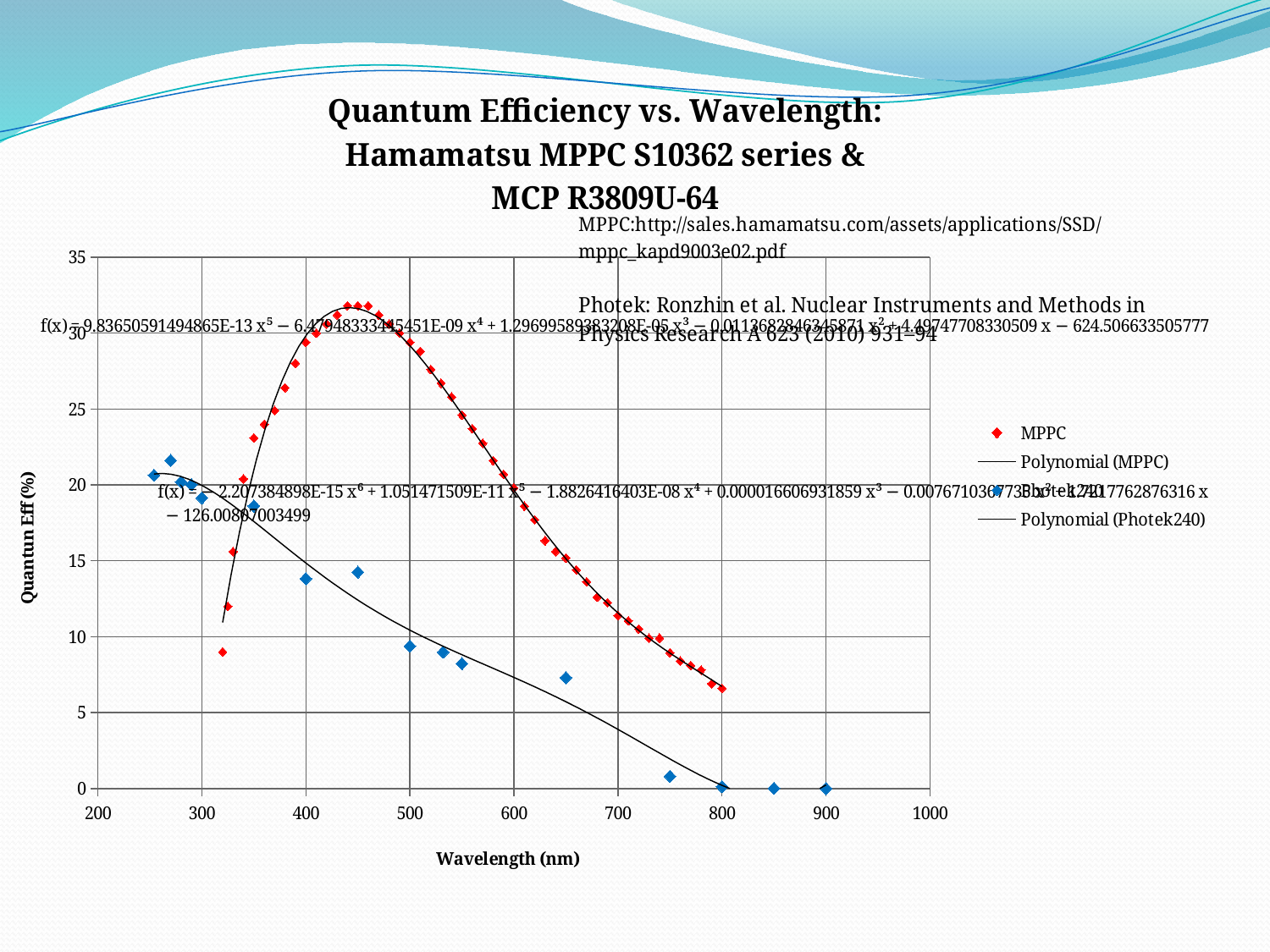
Do the MPPC values rise or fall as wavelength increases from 450 nm to 800 nm? fall Is the MPPC value at 800 nm greater or less than 10? less How many entries does the chart legend list? 4 What is the title of the vertical axis? Quantun Eff (%) What colour are the MPPC data markers? red Is the Photek240 value at 500 nm greater or less than 15? less Is the MPPC value at 450 nm greater or less than 30? greater Which series reaches the higher peak quantum efficiency, MPPC or Photek240? MPPC What kind of chart is shown on the slide? scatter chart At 450 nm, which series has the higher value, MPPC or Photek240? MPPC